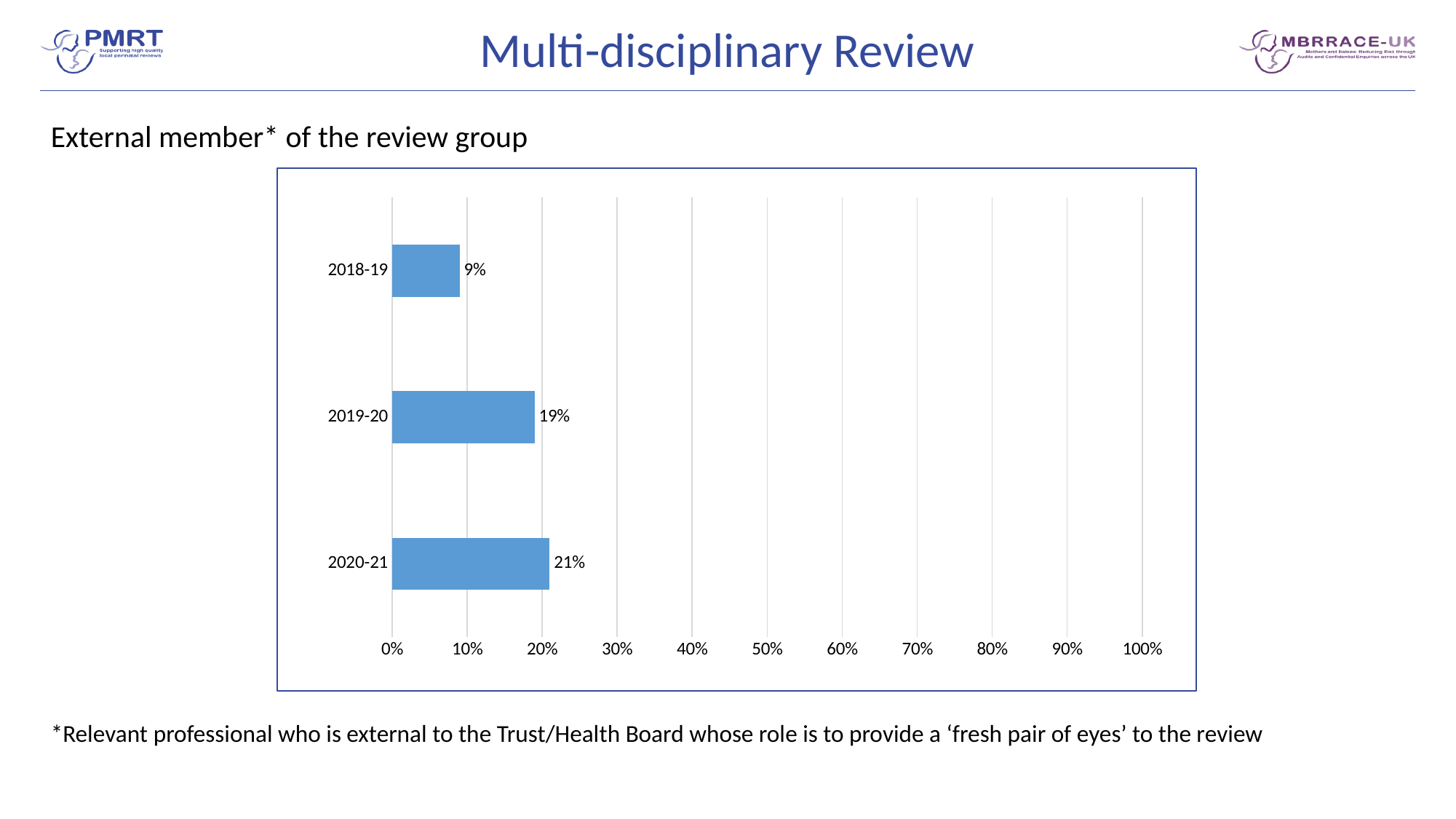
What is the value for 2018-19? 9% How many categories are shown in the chart? 3 What is the value for 2020-21? 21% What is the heading above the chart? External member* of the review group What kind of chart is shown on the slide? Bar chart Which is larger, the value for 2019-20 or the value for 2018-19? 2019-20 Is the value for 2020-21 greater or less than 20%? greater What is the value for 2019-20? 19% Which year has the highest value? 2020-21 What is the difference between the values for 2020-21 and 2018-19? 12% Which year has the lowest value? 2018-19 What is the difference between the values for 2019-20 and 2018-19? 10%